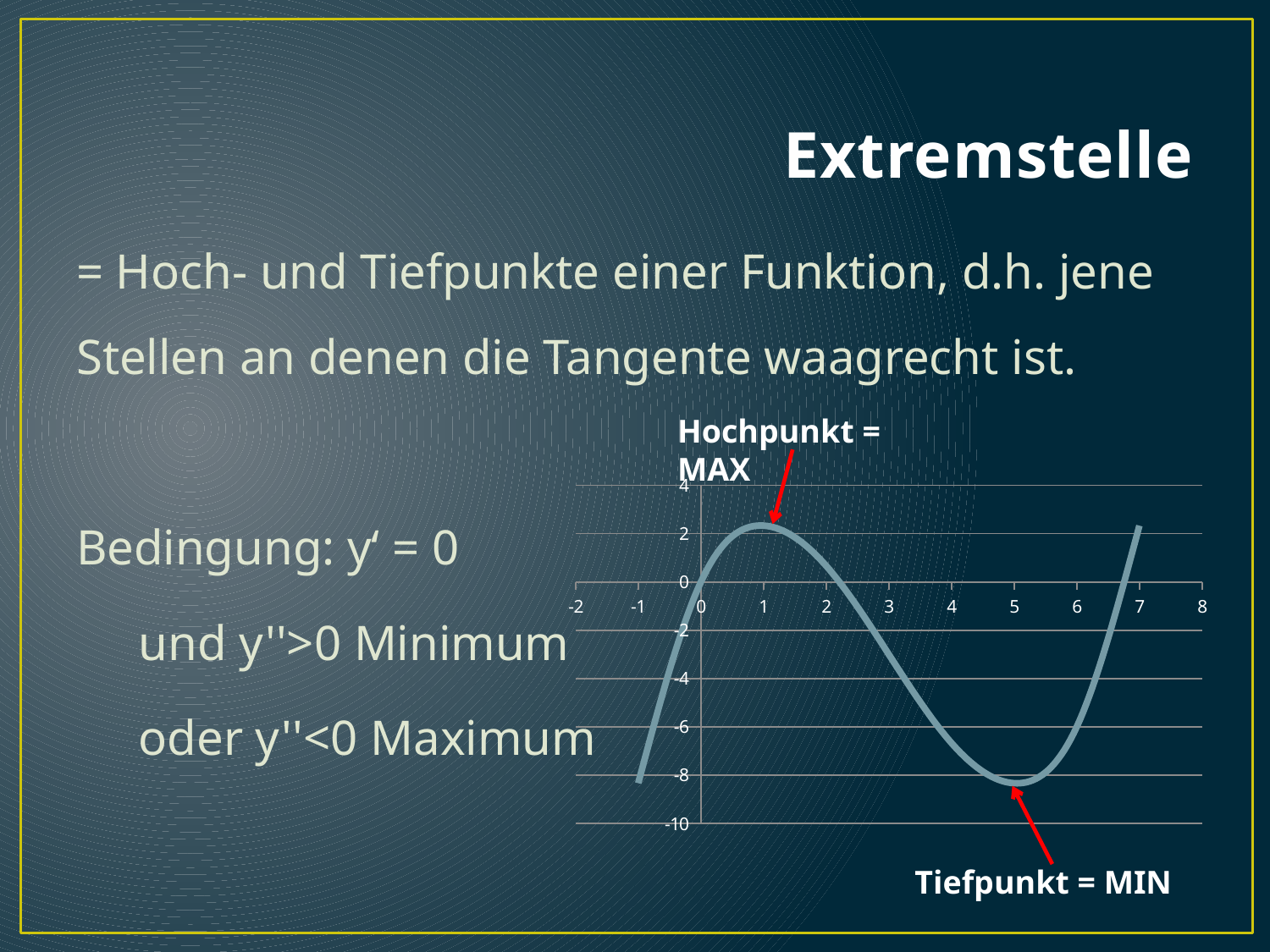
What label is attached to the arrow pointing at the highest point of the curve? Hochpunkt = MAX Is the value of the curve at x = 7 greater or less than 0? greater What kind of chart is shown on the slide? line chart Which is larger, the value of the curve at x = 1 or at x = 5? x = 1 What is the lowest tick value shown on the y axis? -10 What is the highest tick value shown on the y axis? 4 What label is attached to the arrow pointing at the lowest point of the curve? Tiefpunkt = MIN Does the curve rise or fall between x = 1 and x = 5? fall Does the curve rise or fall between x = 5 and x = 7? rise Is the value of the curve at x = 5 greater or less than -4? less Is the value of the curve at x = -1 greater or less than -4? less